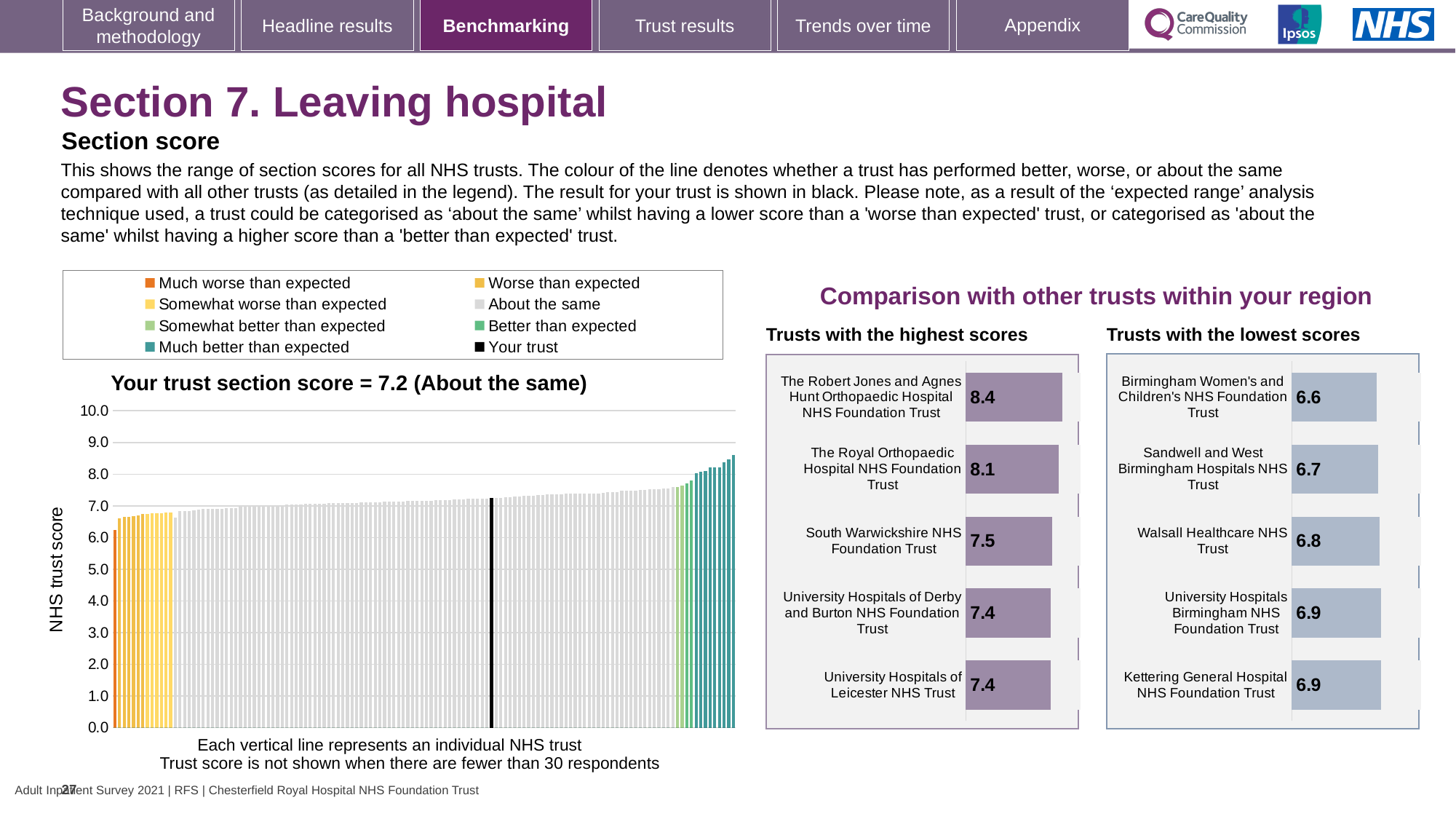
In the main chart on the left, is the value of the tallest bar greater or less than 8.0? greater In the 'Trusts with the highest scores' chart, which trust has the highest score? The Robert Jones and Agnes Hunt Orthopaedic Hospital NHS Foundation Trust In the 'Trusts with the lowest scores' chart, what is the difference between the scores of Walsall Healthcare NHS Trust and Birmingham Women's and Children's NHS Foundation Trust? 0.2 How many trusts are listed in the 'Trusts with the highest scores' chart? 5 In the 'Trusts with the highest scores' chart, what is the difference between the scores of The Robert Jones and Agnes Hunt Orthopaedic Hospital NHS Foundation Trust and The Royal Orthopaedic Hospital NHS Foundation Trust? 0.3 In the 'Trusts with the lowest scores' chart, which has the larger score: Sandwell and West Birmingham Hospitals NHS Trust or Walsall Healthcare NHS Trust? Walsall Healthcare NHS Trust In the main chart on the left, what is the section score for your trust? 7.2 In the 'Trusts with the lowest scores' chart, which trust has the lowest score? Birmingham Women's and Children's NHS Foundation Trust How many entries does the legend above the main chart on the left list? 8 In the 'Trusts with the highest scores' chart, what is the score for The Robert Jones and Agnes Hunt Orthopaedic Hospital NHS Foundation Trust? 8.4 In the 'Trusts with the highest scores' chart, what is the score for South Warwickshire NHS Foundation Trust? 7.5 In the 'Trusts with the lowest scores' chart, what is the score for Walsall Healthcare NHS Trust? 6.8